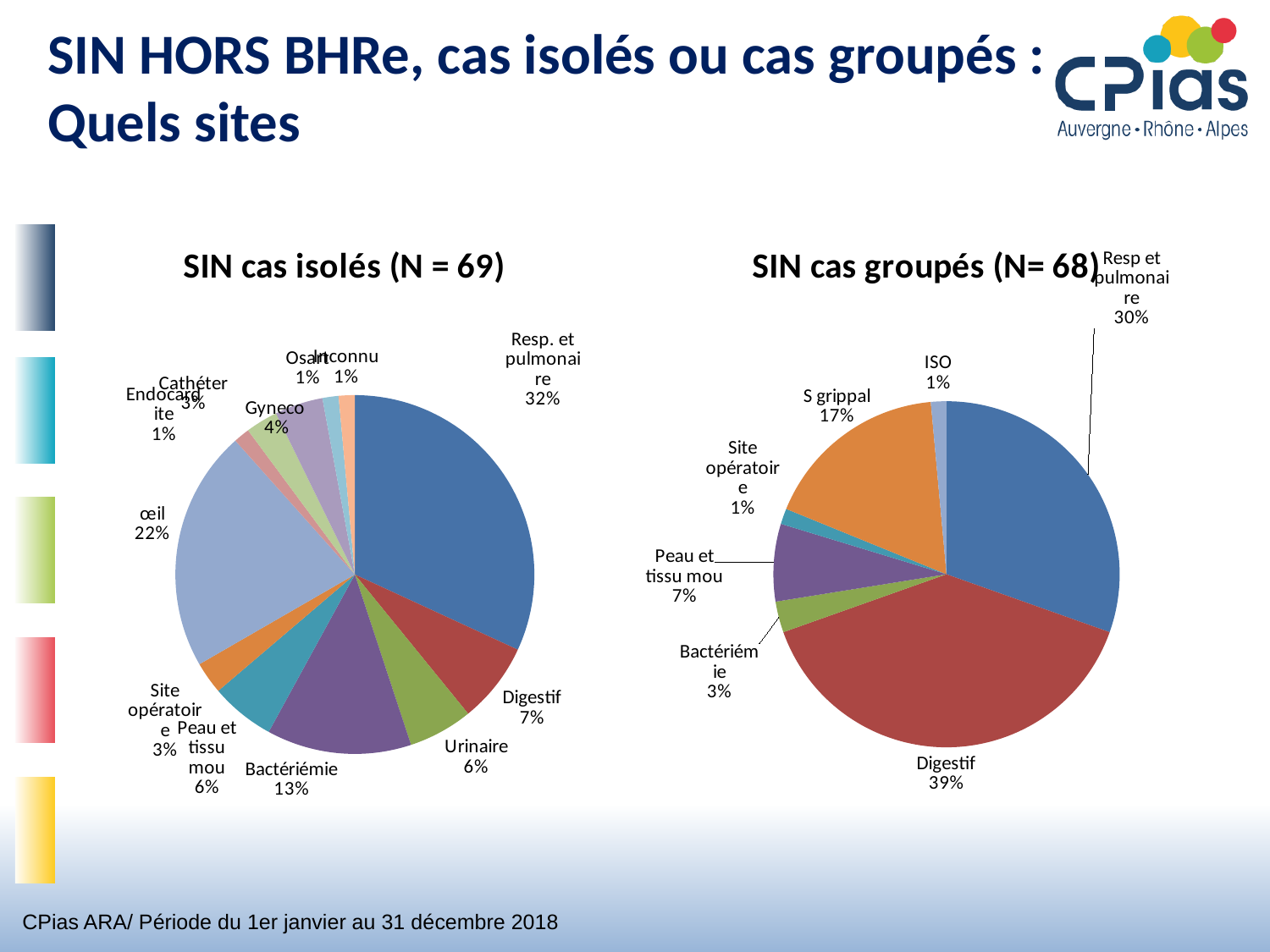
In the 'SIN cas groupés (N= 68)' pie chart, what share is labelled for S grippal? 17% In the 'SIN cas groupés (N= 68)' pie chart, what share is labelled for Digestif? 39% In the 'SIN cas isolés (N = 69)' pie chart, what share is labelled for œil? 22% In the 'SIN cas groupés (N= 68)' pie chart, what is the difference between the Digestif share and the Resp et pulmonaire share? 9% In the 'SIN cas groupés (N= 68)' pie chart, which is larger: Peau et tissu mou or Bactériémie? Peau et tissu mou In the 'SIN cas isolés (N = 69)' pie chart, what share is labelled for Bactériémie? 13% In the 'SIN cas isolés (N = 69)' pie chart, what is the difference between the Resp. et pulmonaire share and the œil share? 10% What type of chart is used for 'SIN cas isolés (N = 69)'? Pie chart In the 'SIN cas isolés (N = 69)' pie chart, which category has the largest slice? Resp. et pulmonaire How many slices does the 'SIN cas groupés (N= 68)' pie chart have? 7 In the 'SIN cas isolés (N = 69)' pie chart, what share is labelled for Resp. et pulmonaire? 32% In the 'SIN cas groupés (N= 68)' pie chart, which category has the largest slice? Digestif